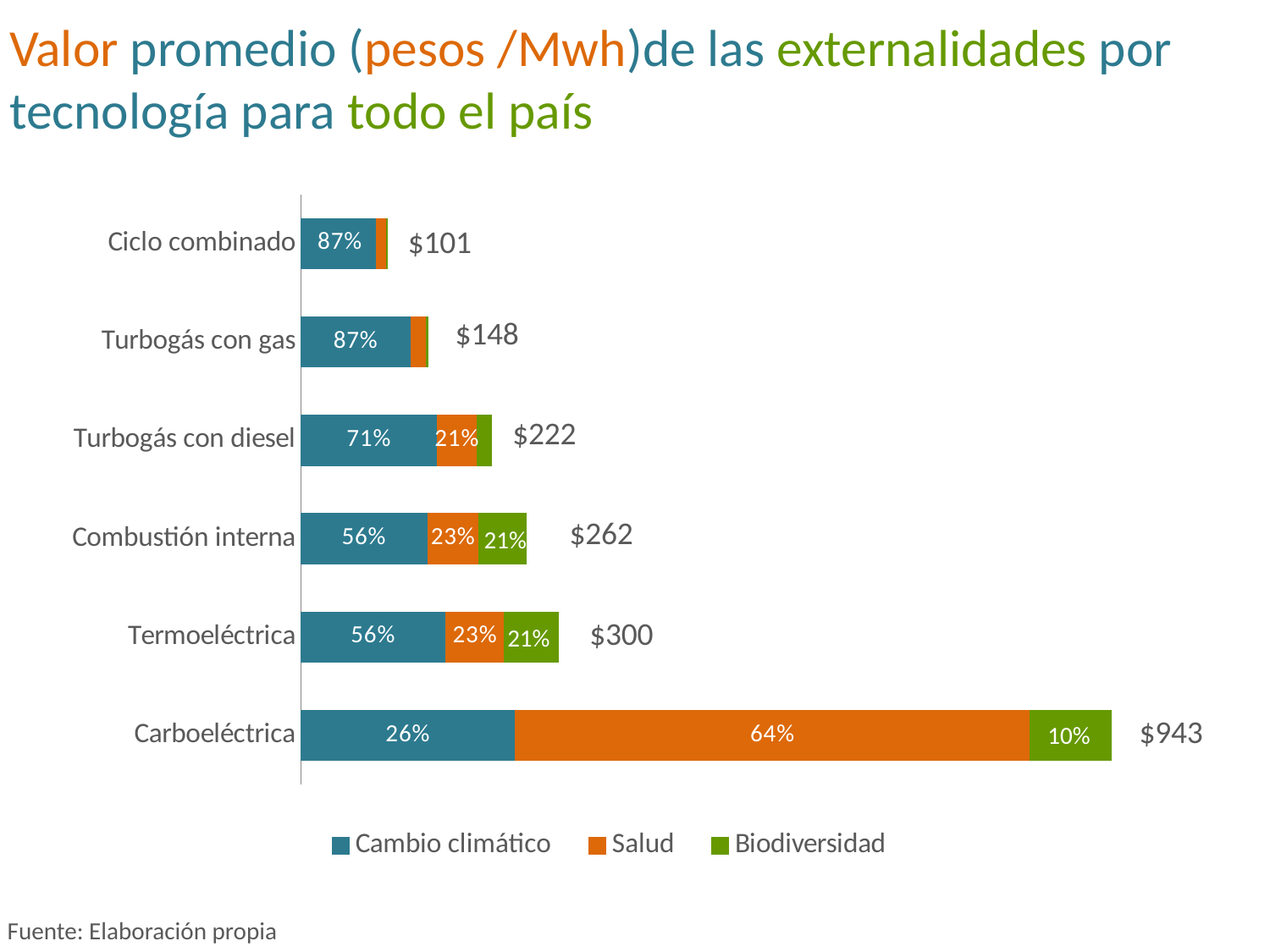
Which technology has the lowest total value? Ciclo combinado What are the three series listed in the legend? Cambio climático, Salud, Biodiversidad What is the total value shown for Combustión interna? $262 What is the difference between the total values for Carboeléctrica and Termoeléctrica? $643 How many series does the legend list? 3 How many technologies are shown in the chart? 6 Which has a larger total value, Termoeléctrica or Combustión interna? Termoeléctrica Which technology has the highest total value? Carboeléctrica What is the total value shown for Carboeléctrica? $943 What percentage of the Carboeléctrica bar is Salud? 64% What kind of chart is shown on the slide? Stacked bar chart What percentage of the Turbogás con diesel bar is Cambio climático? 71%